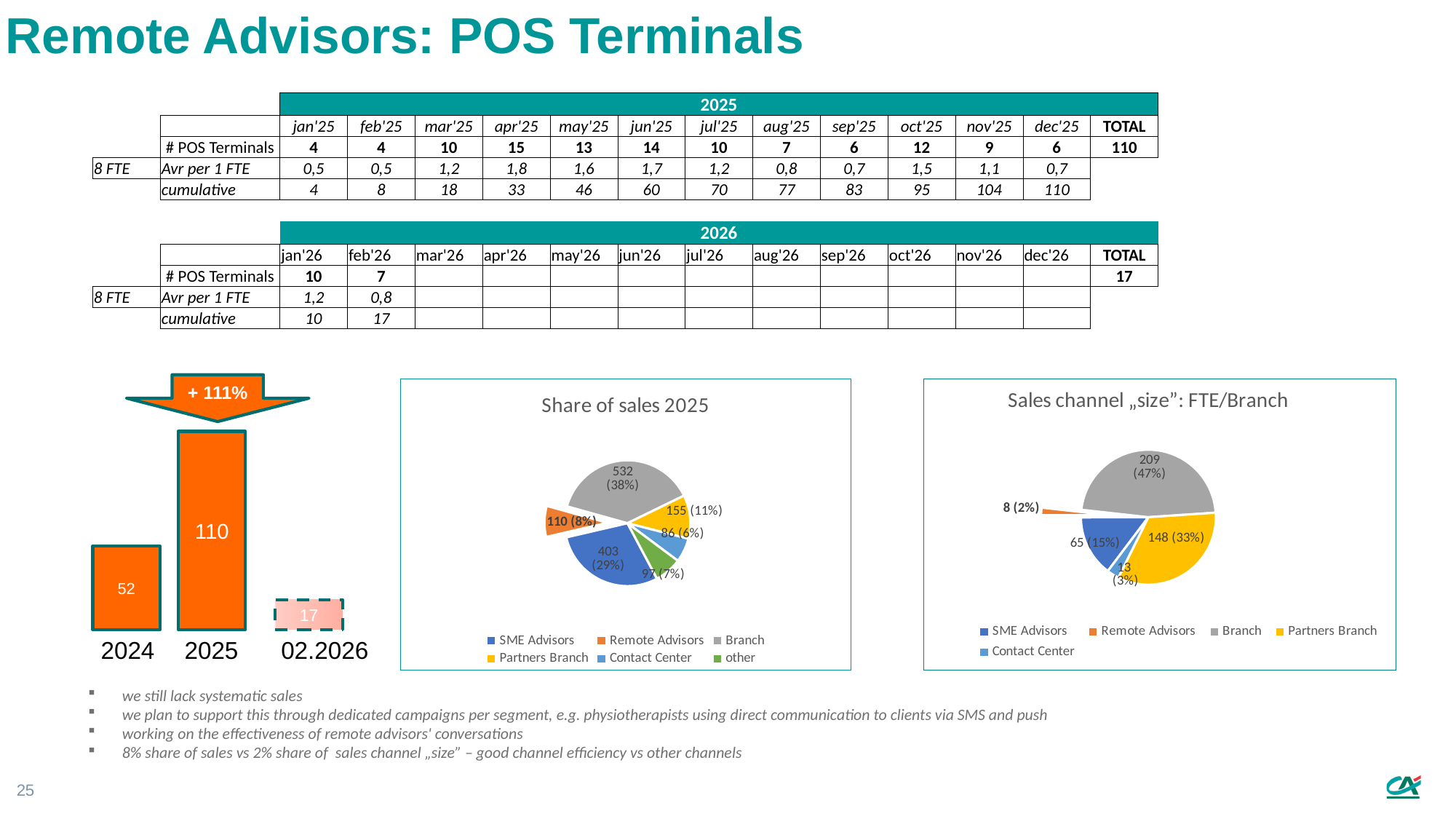
In the 'Share of sales 2025' pie chart, what is the value for Remote Advisors? 110 (8%) In the bar chart on the left, what is the difference between the 2025 and 2024 values? 58 In the bar chart on the left, what is the value for 2024? 52 What kind of chart is the 'Share of sales 2025' chart? pie chart In the bar chart on the left, which year has the highest value? 2025 In the 'Share of sales 2025' pie chart, which category has the smallest slice? Contact Center In the 'Sales channel „size": FTE/Branch' pie chart, which is larger, SME Advisors or Contact Center? SME Advisors In the 'Sales channel „size": FTE/Branch' pie chart, what is the value for Partners Branch? 148 (33%) In the 'Share of sales 2025' pie chart, what share does Branch have? 38% In the bar chart on the left, how many bars are shown? 3 How many entries does the legend of the 'Share of sales 2025' pie chart list? 6 In the bar chart on the left, what is the value for 2025? 110